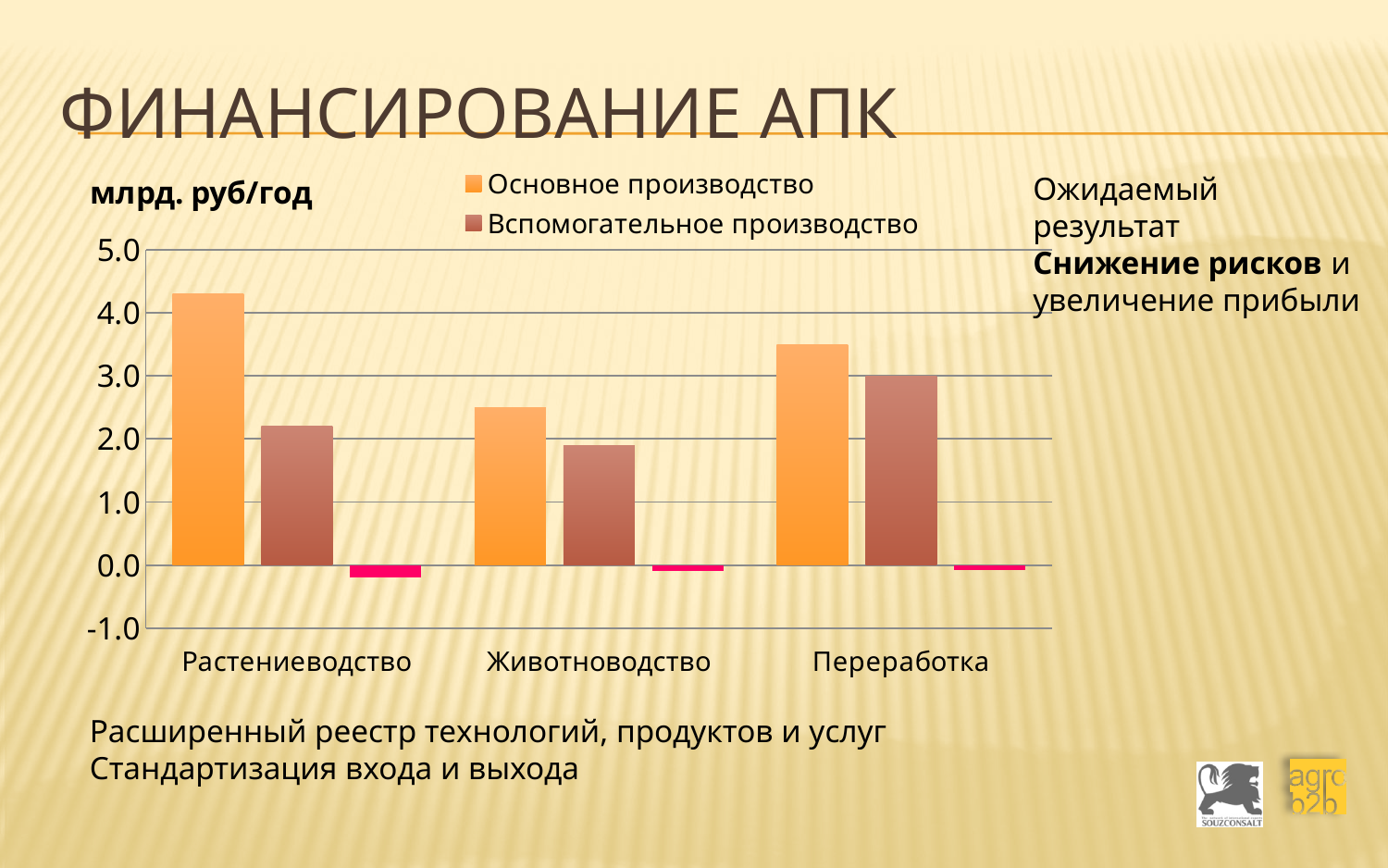
Which category has the lowest value for Основное производство? Животноводство Which category has the highest value for Основное производство? Растениеводство Which is larger in Переработка: Основное производство or Вспомогательное производство? Основное производство Is the value for Основное производство in Переработка greater or less than 3.0? greater Is the value for Вспомогательное производство in Животноводство greater or less than 2.0? less How many categories are shown on the x axis of the chart? 3 How many series does the chart's legend list? 2 What kind of chart is shown on the slide? bar chart What unit label is shown above the chart's vertical axis? млрд. руб/год Which category has the highest value for Вспомогательное производство? Переработка Is the value for Основное производство in Растениеводство greater or less than 4.0? greater Which category has the lowest value for Вспомогательное производство? Животноводство